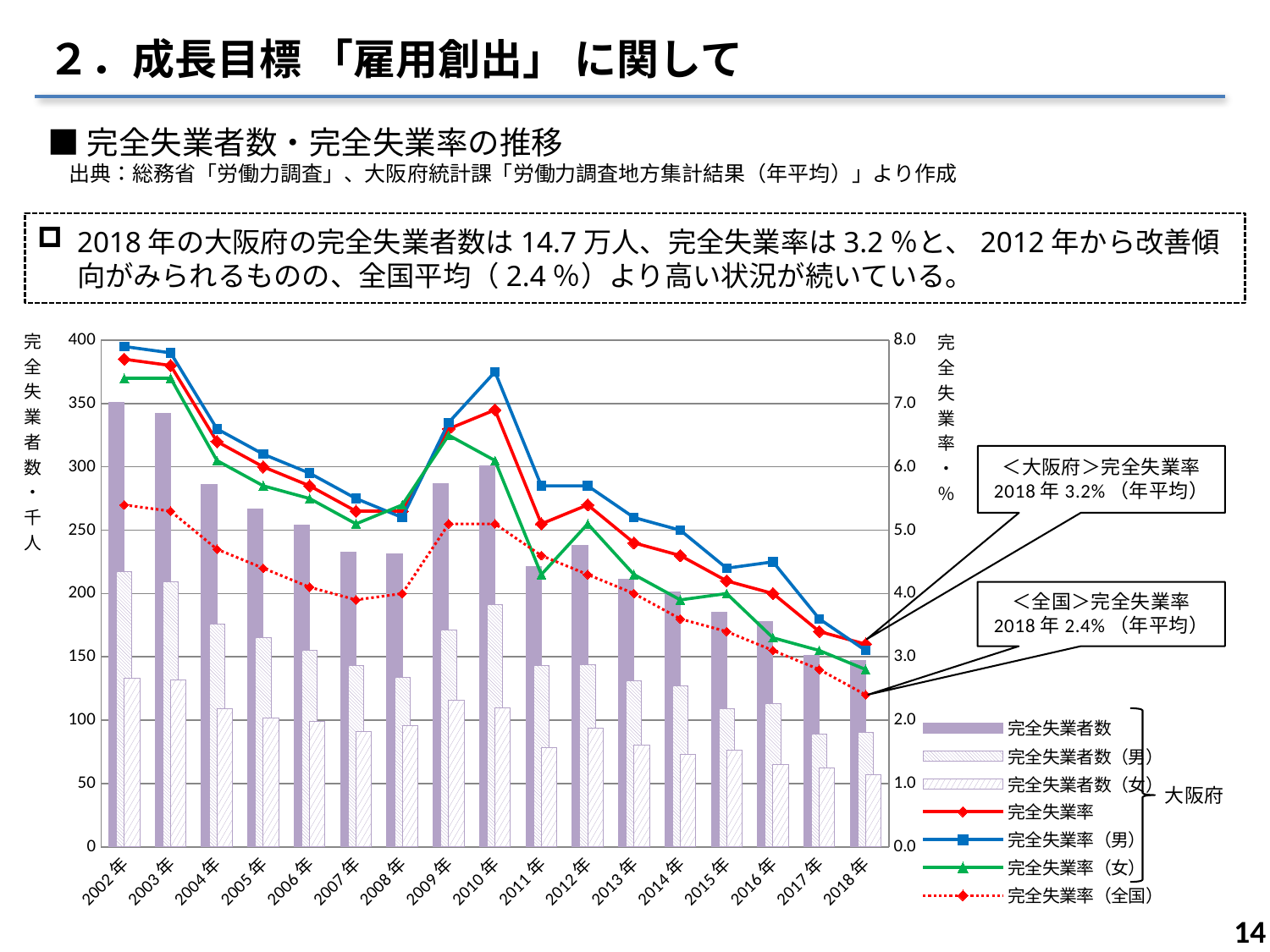
What kind of chart is shown on the slide? Combined bar and line chart What is the difference between the 2018 完全失業率 for 大阪府 and for 全国? 0.8 percentage points Does the 完全失業率（男） line rise or fall from 2010年 to 2018年? fall In 2018, which is higher: the 完全失業率 for 大阪府 or for 全国? 大阪府 What is the 2018 完全失業率 for 全国 according to the callout on the chart? 2.4% Is the 完全失業者数 value for 2018年 greater or less than 200? less What is the 2018 完全失業率 for 大阪府 according to the callout on the chart? 3.2% How many years are shown on the x axis of the chart? 17 Is the 完全失業者数 value for 2002年 greater or less than 300? greater How many series does the chart legend list? 7 In 2010年, which is higher: 完全失業率（男） or 完全失業率（女）? 完全失業率（男） In which year is the 完全失業者数 bar the highest? 2002年